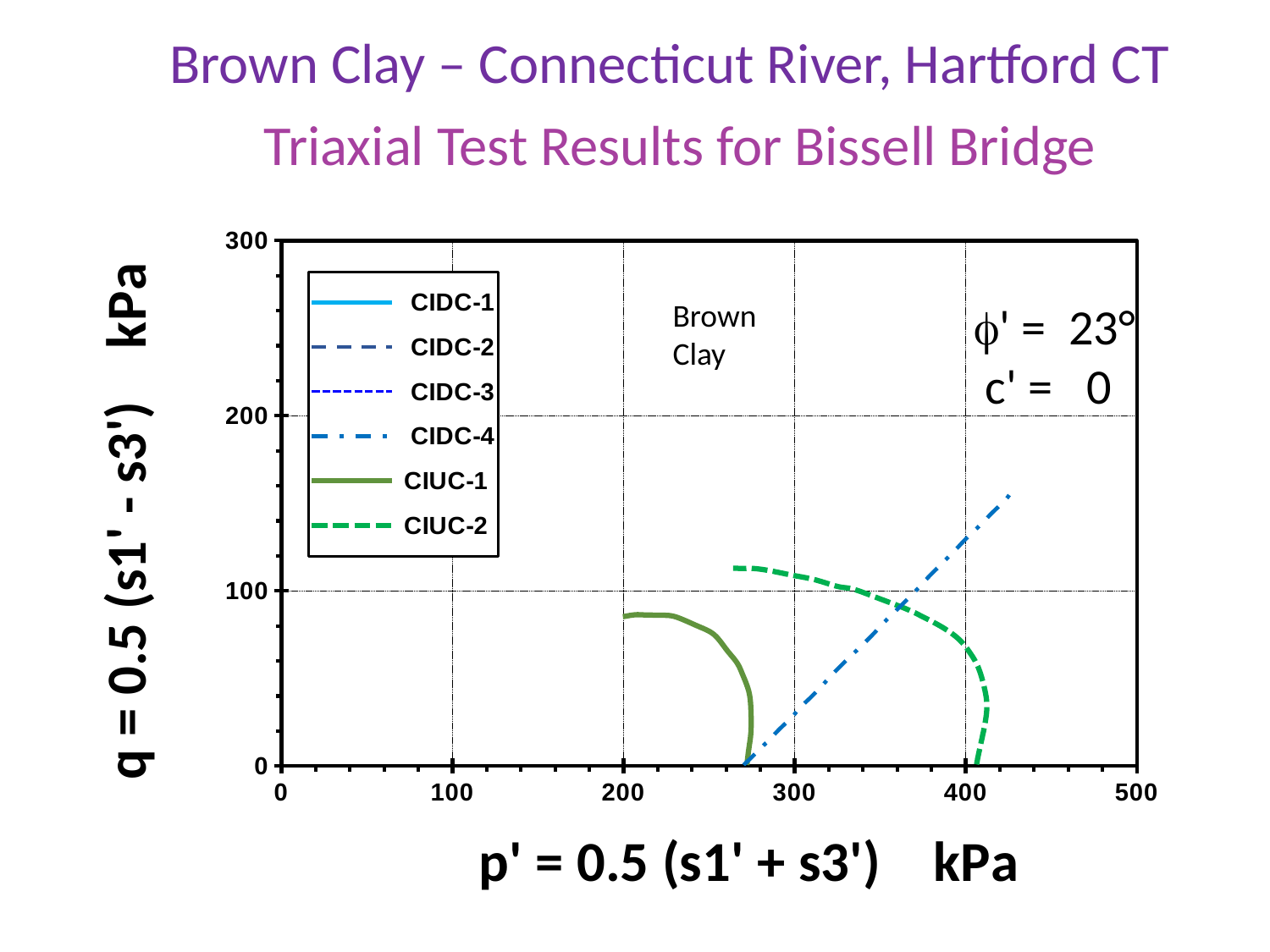
How many series does the legend list? 6 Is the highest q value reached by the CIDC-4 line greater or less than 100 kPa? greater What kind of chart is shown on the slide? line chart What is the value of c' shown on the chart? 0 Is the peak q value of the CIUC-2 stress path greater or less than 100 kPa? greater What is the value of φ' shown on the chart? 23° Which stress path reaches a higher peak q value, CIUC-1 or CIUC-2? CIUC-2 What is the label of the x axis? p' = 0.5 (s1' + s3') kPa What is the maximum value shown on the y axis? 300 Which stress path starts at a higher p' value on the x axis, CIUC-1 or CIUC-2? CIUC-2 Is the peak q value of the CIUC-1 stress path greater or less than 100 kPa? less